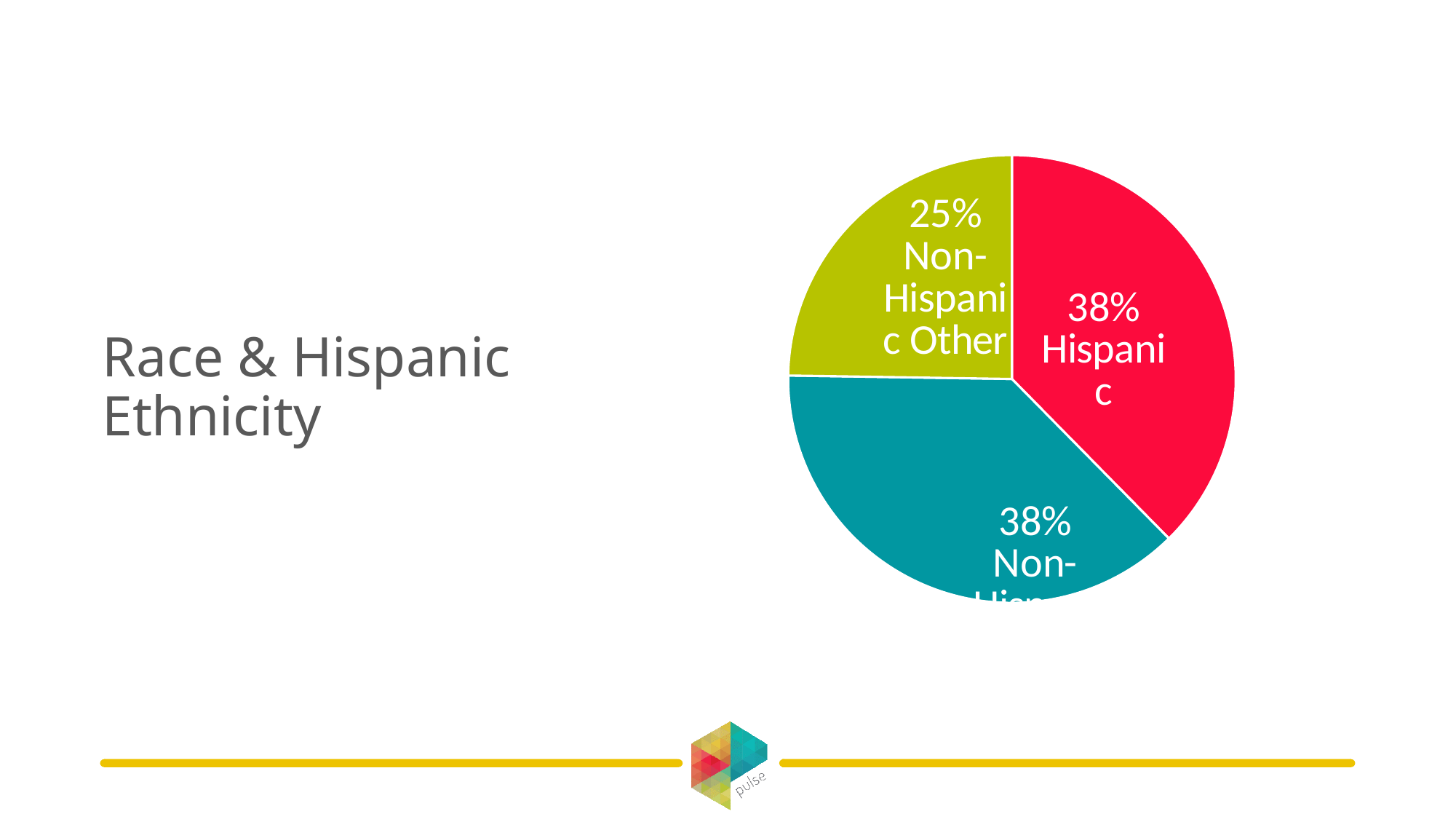
How many slices does the pie chart have? 3 What percentage of the pie is labelled Non-Hispanic Other? 25% Which is larger: the Hispanic slice or the Non-Hispanic Other slice? Hispanic What colour is the Hispanic slice of the pie chart? Red Is the Hispanic slice larger or smaller than the teal slice? They are equal (both 38%) Which slice of the pie chart is the smallest? Non-Hispanic Other What is the title of the slide containing the pie chart? Race & Hispanic Ethnicity What percentage of the pie is labelled Hispanic? 38% What percentage is shown on the teal slice of the pie chart? 38% By how many percentage points is the Hispanic slice larger than the Non-Hispanic Other slice? 13 percentage points What kind of chart is shown on the slide? Pie chart